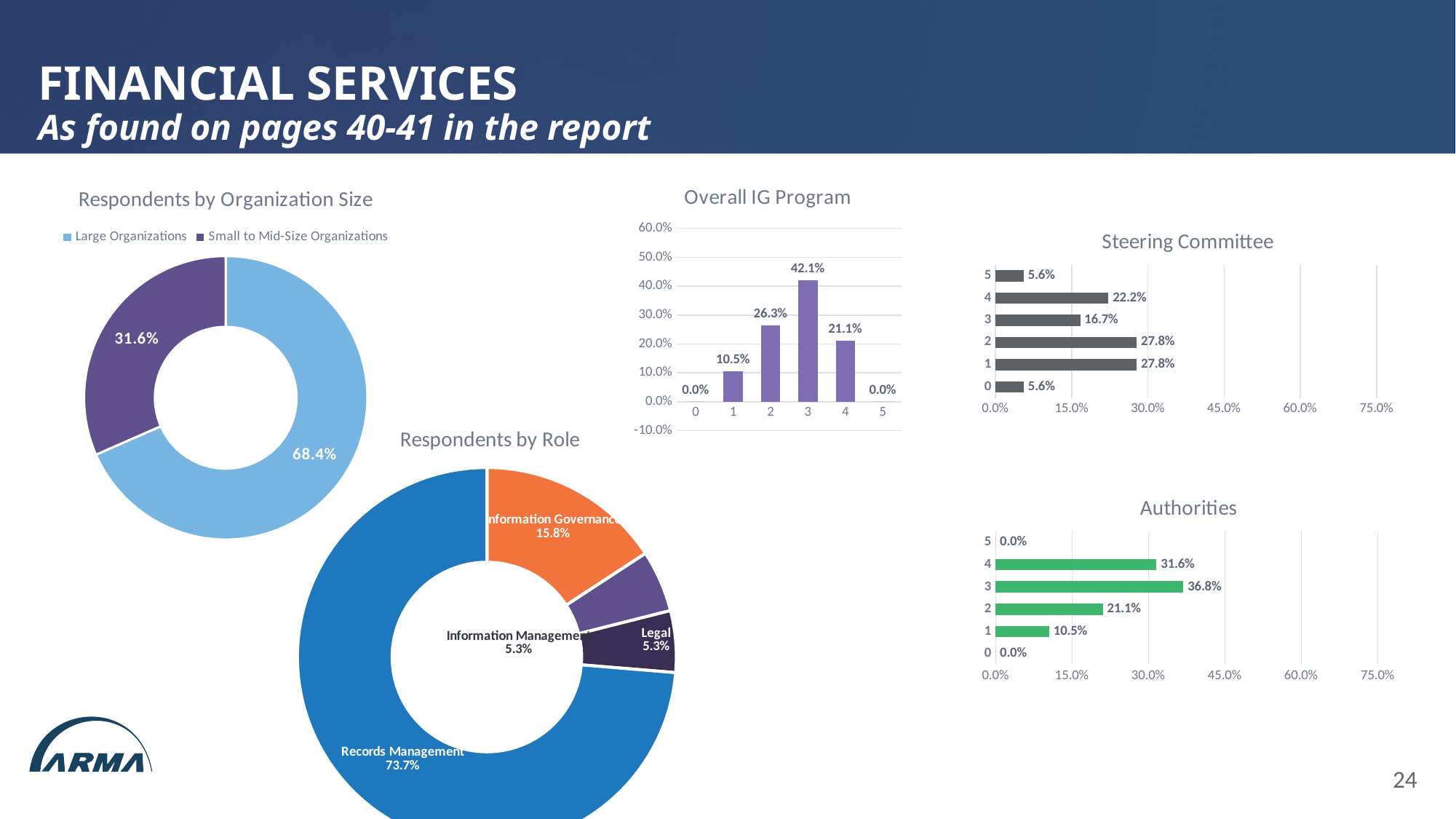
In the Authorities chart, what is the value for rating 1? 10.5% In the Authorities chart, is the value for rating 4 greater or less than 30.0%? greater In the Steering Committee chart, which is larger, the value for rating 3 or the value for rating 4? rating 4 In the Overall IG Program chart, what is the value for rating 2? 26.3% In the Respondents by Organization Size chart, what share of the donut is Small to Mid-Size Organizations? 31.6% In the Respondents by Role chart, what percentage of respondents are in Records Management? 73.7% In the Steering Committee chart, what is the value for rating 4? 22.2% In the Respondents by Organization Size chart, what percentage of respondents are from Large Organizations? 68.4% What kind of chart is the Steering Committee chart? bar chart In the Overall IG Program chart, what is the difference between the values for rating 3 and rating 4? 21.0% In the Authorities chart, which rating has the highest value? 3 In the Overall IG Program chart, which rating has the highest value? 3